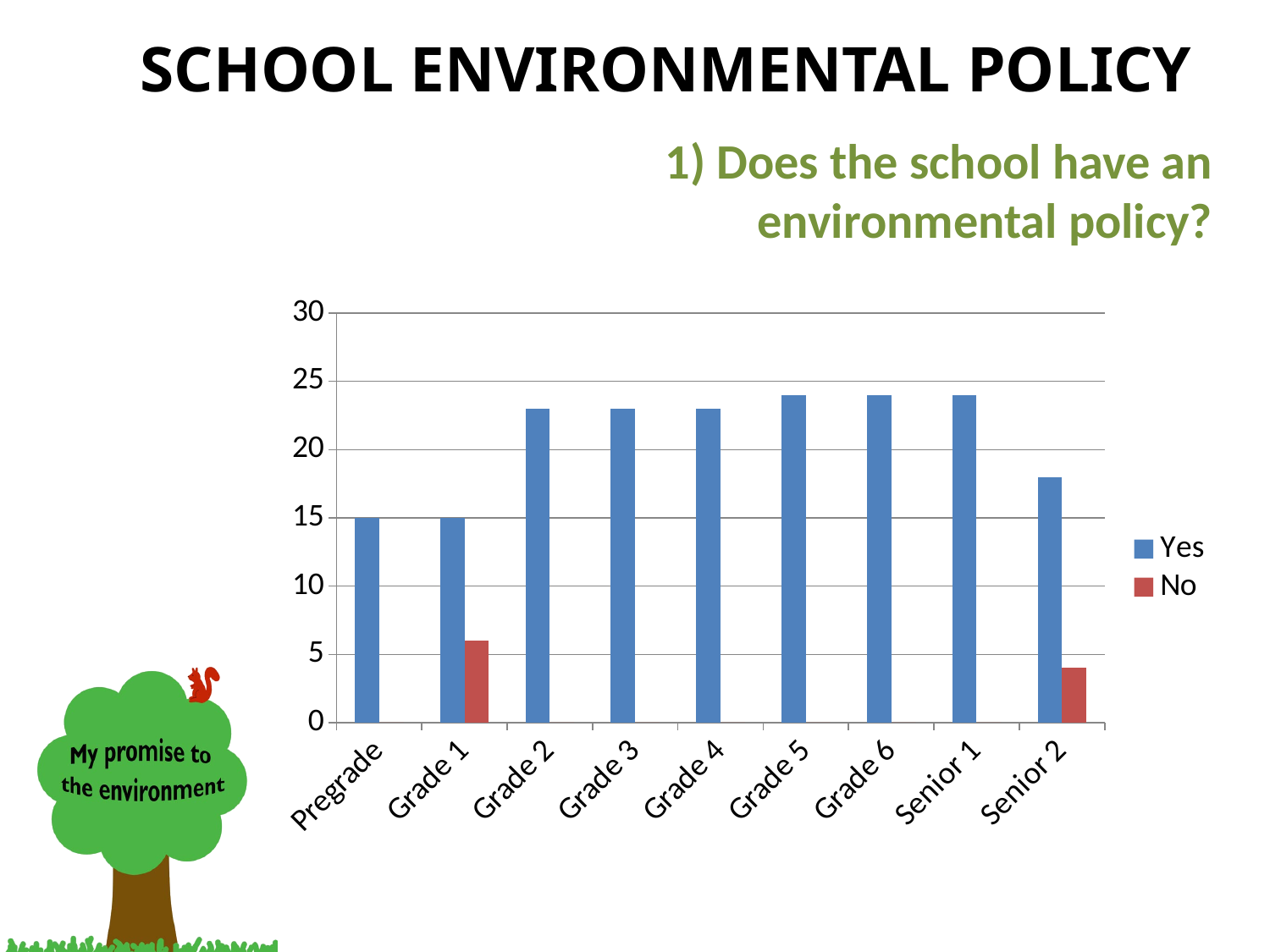
What are the two entries in the legend? Yes and No Which is larger, the Yes value for Grade 2 or the Yes value for Senior 2? Grade 2 Is the No value for Senior 2 greater or less than 5? less Which category has the highest No value? Grade 1 Is the Yes value for Senior 2 greater or less than 20? less What is the Yes value for Pregrade? 15 What is the Yes value for Grade 1? 15 How many categories are shown on the x axis? 9 How many series does the legend list? 2 What kind of chart is shown on the slide? bar chart Is the No value for Grade 1 greater or less than 5? greater